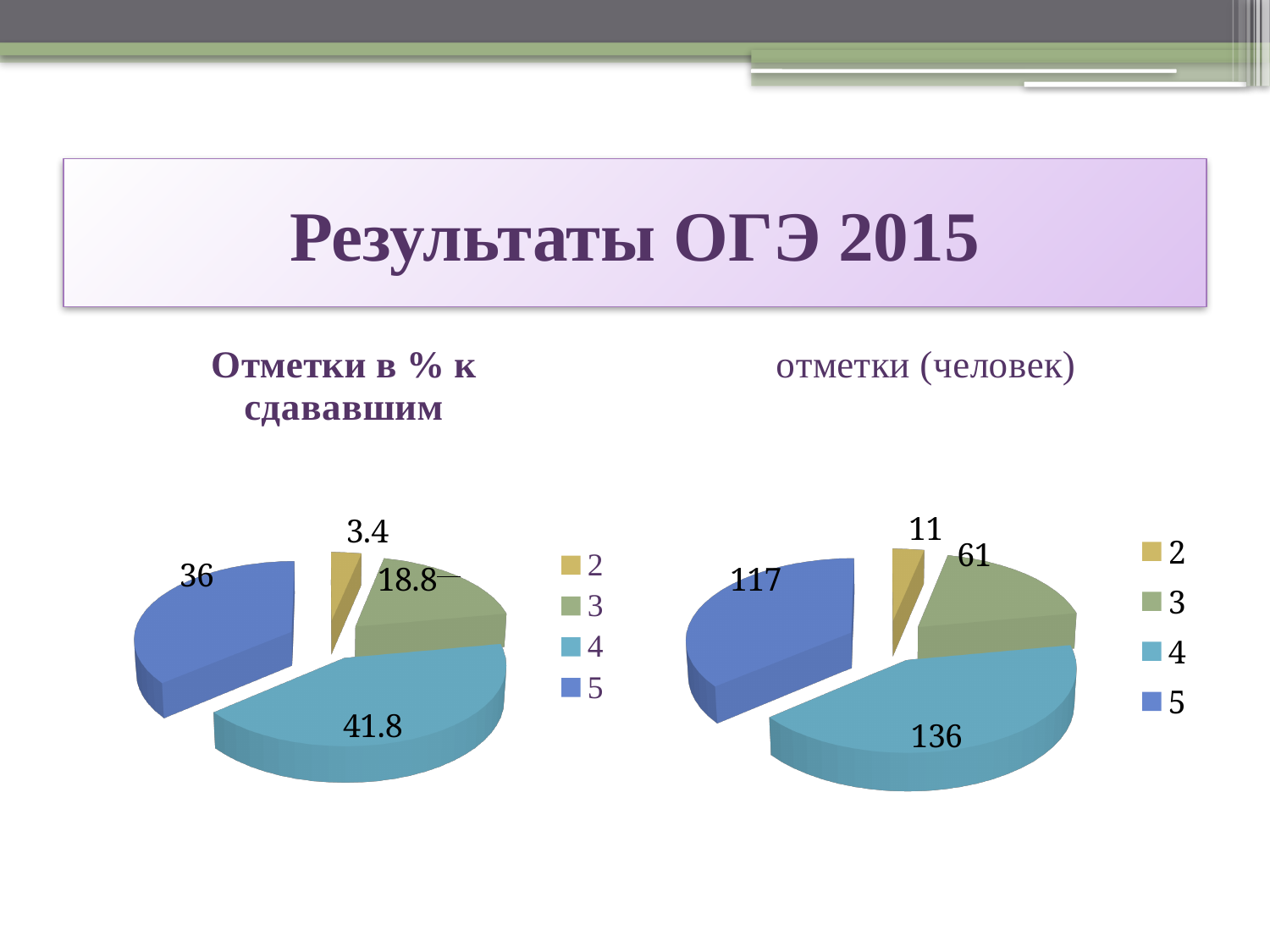
In the right chart 'отметки (человек)', how many people received grade 5? 117 In the right chart 'отметки (человек)', how many people received grade 3? 61 In the left chart 'Отметки в % к сдававшим', what is the value for grade 4? 41.8 In the right chart 'отметки (человек)', which is larger: the slice for grade 3 or the slice for grade 5? 5 In the right chart 'отметки (человек)', what is the difference between the number of people with grade 4 and grade 5? 19 In the right chart 'отметки (человек)', which grade has the largest slice? 4 What type of chart is the right chart 'отметки (человек)'? pie chart In the left chart 'Отметки в % к сдававшим', what is the value for grade 2? 3.4 How many entries does the legend of the left chart 'Отметки в % к сдававшим' list? 4 In the left chart 'Отметки в % к сдававшим', what is the difference between the values for grade 5 and grade 3? 17.2 In the right chart 'отметки (человек)', what is the total number of people across all grades? 325 In the left chart 'Отметки в % к сдававшим', which grade has the smallest slice? 2